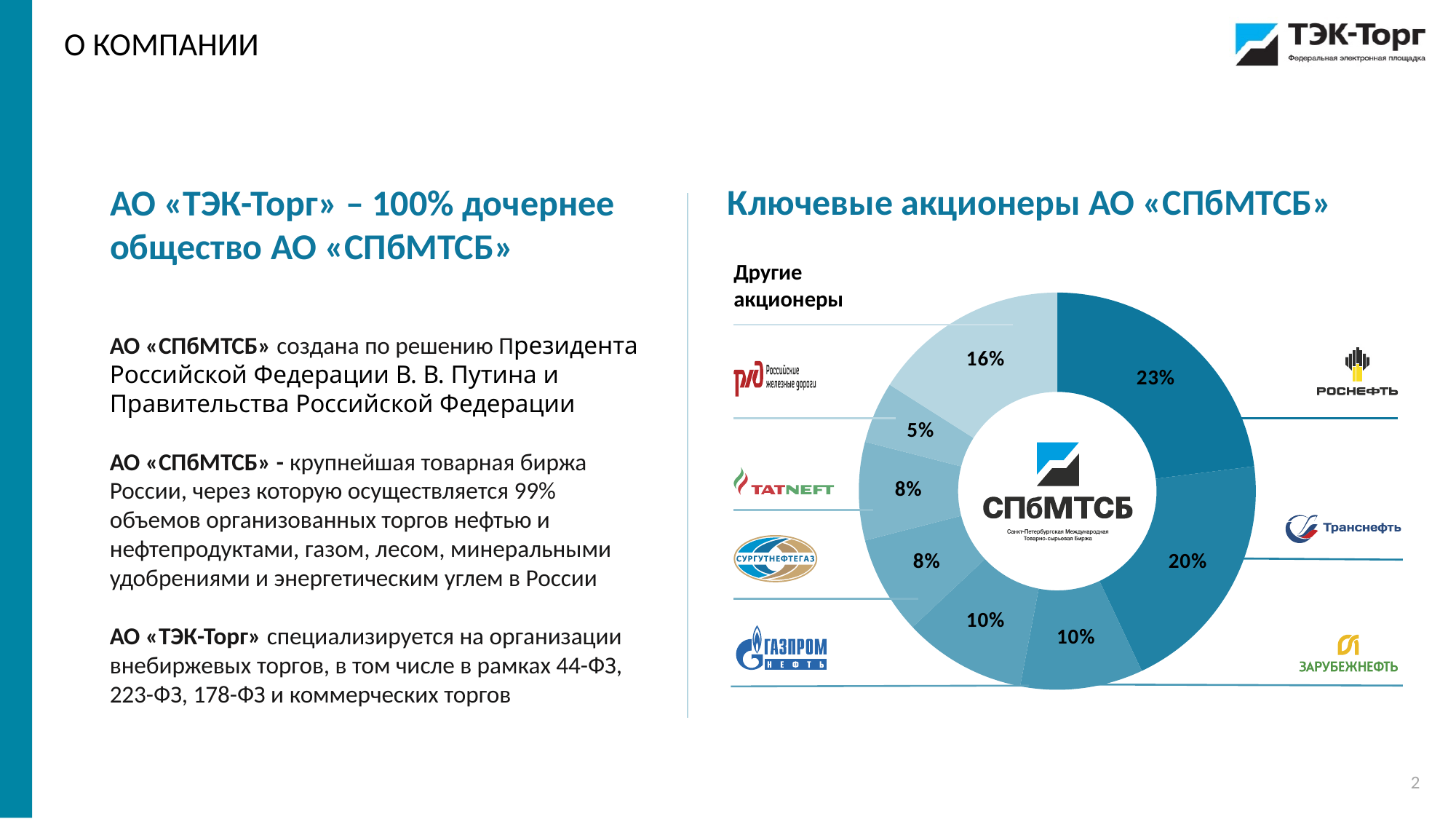
What share does Транснефть hold in the chart «Ключевые акционеры АО «СПбМТСБ»»? 20% Which shareholder has the smallest share in the chart? Российские железные дороги Which shareholder has the largest share in the chart? Роснефть What share is shown for Зарубежнефть? 10% Which is larger: the share of Другие акционеры or the share of Газпром нефть? Другие акционеры By how many percentage points does the share of Роснефть exceed that of Транснефть? 3% What kind of chart is used to show the key shareholders of АО «СПбМТСБ»? Pie (donut) chart What share of АО «СПбМТСБ» is held by Роснефть according to the chart? 23% What share is shown for Российские железные дороги (РЖД)? 5% What percentage is shown for Другие акционеры? 16% How many slices does the shareholder chart have? 8 What is the title of the chart on the right side of the slide? Ключевые акционеры АО «СПбМТСБ»